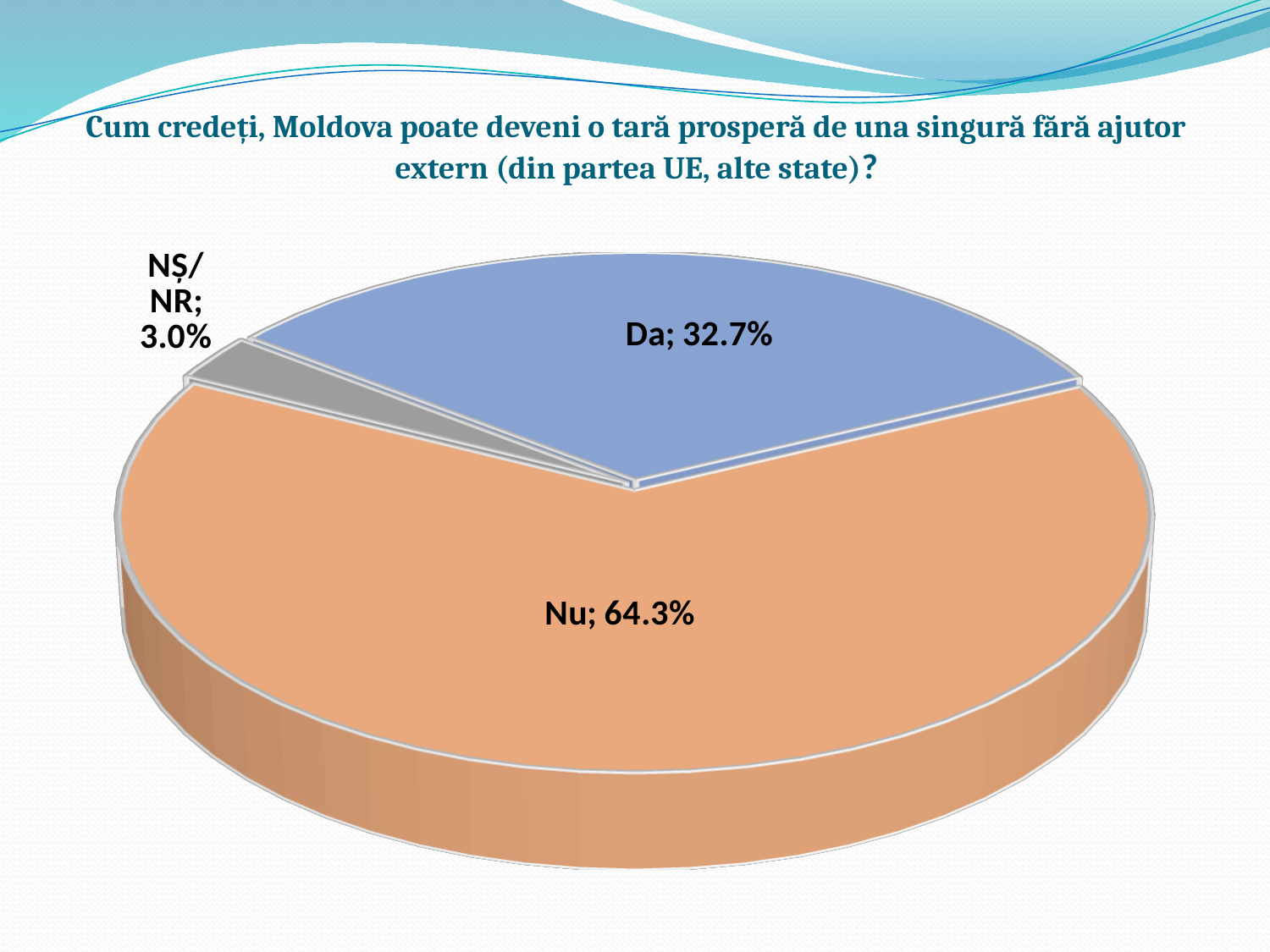
Which is larger, the share for "Da" or the share for "NȘ/NR"? Da What is the value shown for the "NȘ/NR" slice? 3.0% What colour is the "Nu" slice? Orange Which response has the largest share of the pie? Nu What percentage of respondents answered "Nu"? 64.3% What is the difference in percentage points between "Nu" and "Da"? 31.6 What is the combined share of "Da" and "NȘ/NR"? 35.7% What type of chart is shown on the slide? Pie chart What percentage of respondents answered "Da"? 32.7% What colour is the "Da" slice? Blue How many slices does the pie chart have? 3 Which response has the smallest share of the pie? NȘ/NR